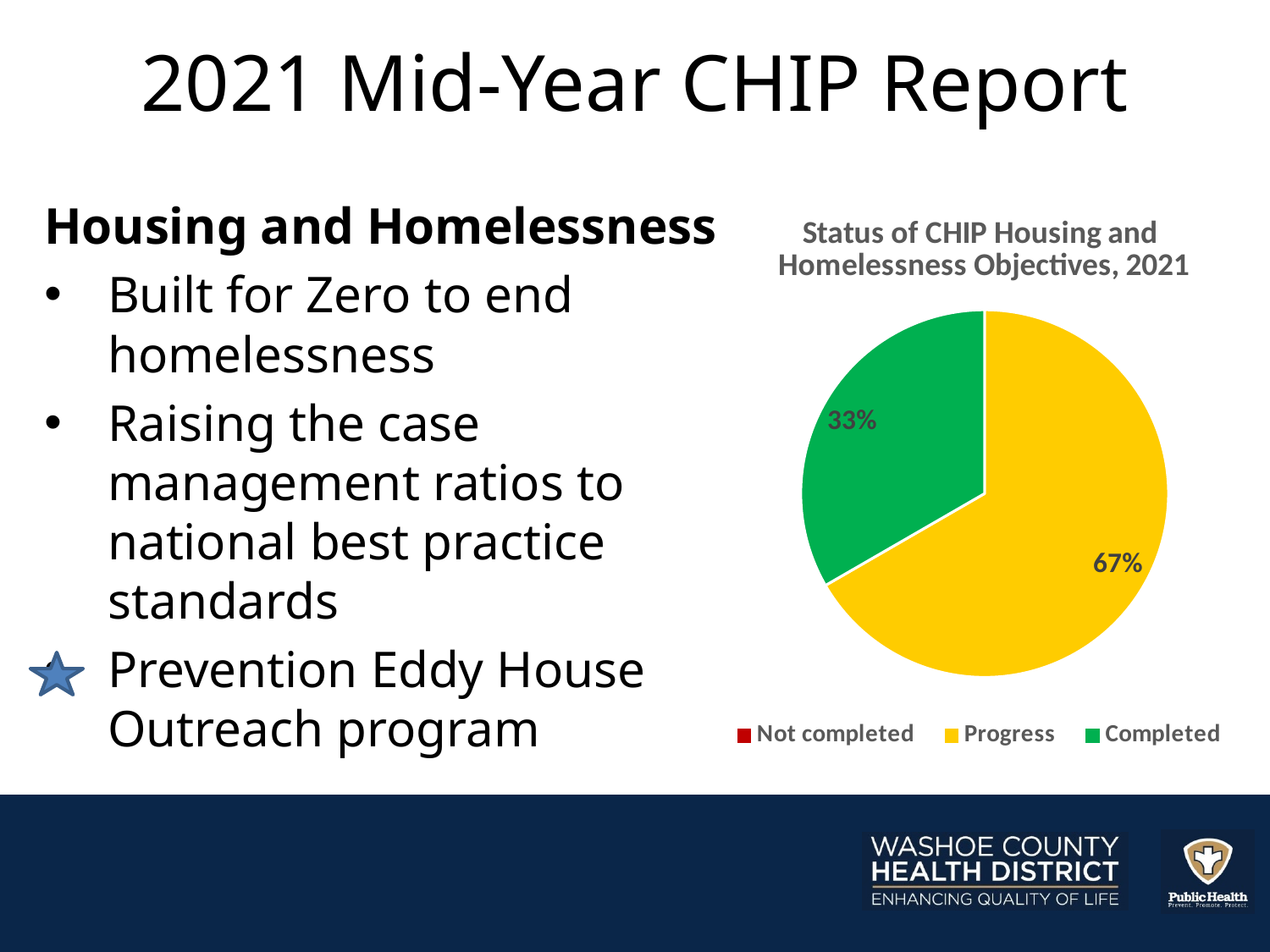
What kind of chart is shown on the slide? Pie chart Is the Progress share greater or less than 50%? greater What percentage of objectives are in Progress? 67% Which of the visible slices is the smallest? Completed Which is larger, the Progress share or the Completed share? Progress Which category has the largest share of the pie? Progress What is the difference between the Progress share and the Completed share? 34% What colour represents the Completed category in the legend? Green What percentage of objectives are Completed? 33% How many slices are visible in the pie? 2 What is the title of the chart? Status of CHIP Housing and Homelessness Objectives, 2021 How many entries does the legend list? 3